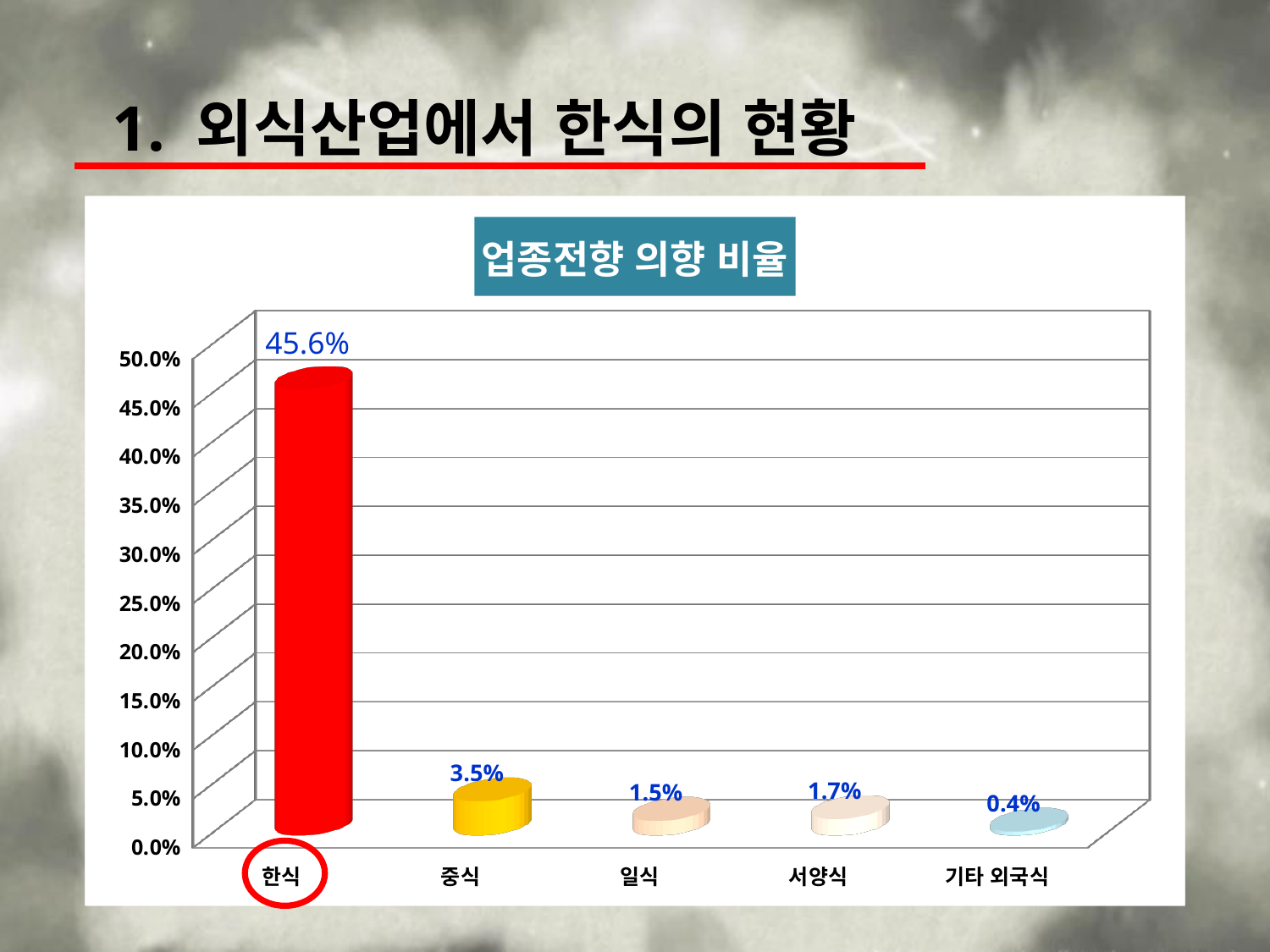
What is the difference between the values for 한식 and 중식? 42.1% What is the value for 기타 외국식? 0.4% What is the value for 서양식? 1.7% What kind of chart is shown on the slide? bar chart What is the value for 중식? 3.5% What is the value for 일식? 1.5% Which is larger, the value for 중식 or the value for 일식? 중식 How many categories are shown on the x axis? 5 What is the title of the chart? 업종전향 의향 비율 Which category has the lowest value? 기타 외국식 What is the value for 한식? 45.6% Which category has the highest value? 한식